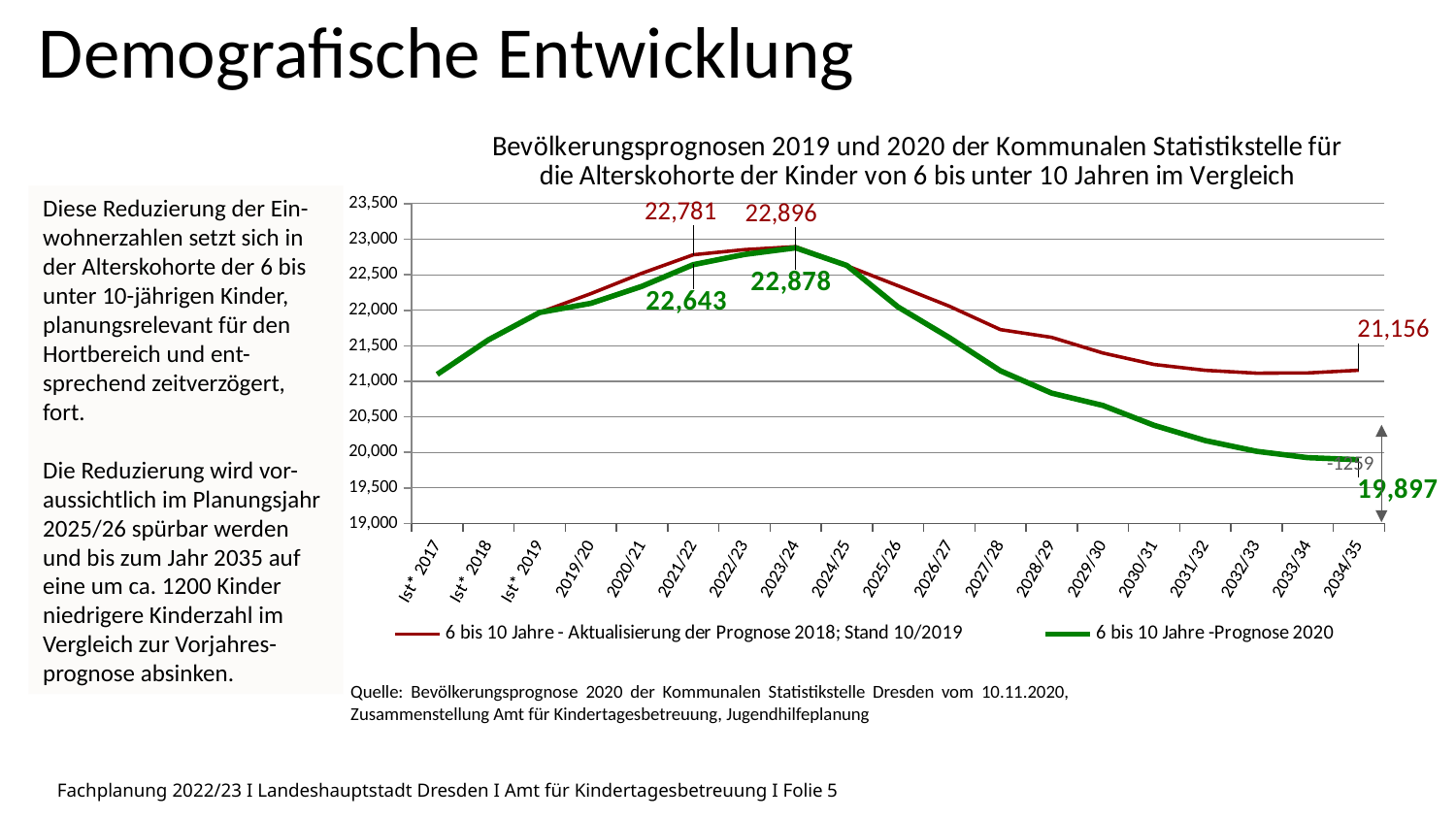
What is the value of the series '6 bis 10 Jahre -Prognose 2020' for 2023/24? 22,878 Do the values of the series '6 bis 10 Jahre -Prognose 2020' rise or fall from 2023/24 to 2034/35? fall Is the value of the series '6 bis 10 Jahre -Prognose 2020' for 2029/30 greater or less than 21,000? less Which series has the higher value for 2034/35? 6 bis 10 Jahre - Aktualisierung der Prognose 2018; Stand 10/2019 What is the difference between the two series' values for 2034/35? 1,259 What is the difference between the two series' values for 2023/24? 18 What is the value of the series '6 bis 10 Jahre - Aktualisierung der Prognose 2018; Stand 10/2019' for 2021/22? 22,781 What kind of chart is shown on the slide? line chart How many series does the chart legend list? 2 What is the value of the series '6 bis 10 Jahre -Prognose 2020' for 2034/35? 19,897 How many categories are shown along the x axis of the chart? 19 What is the value of the series '6 bis 10 Jahre - Aktualisierung der Prognose 2018; Stand 10/2019' for 2034/35? 21,156